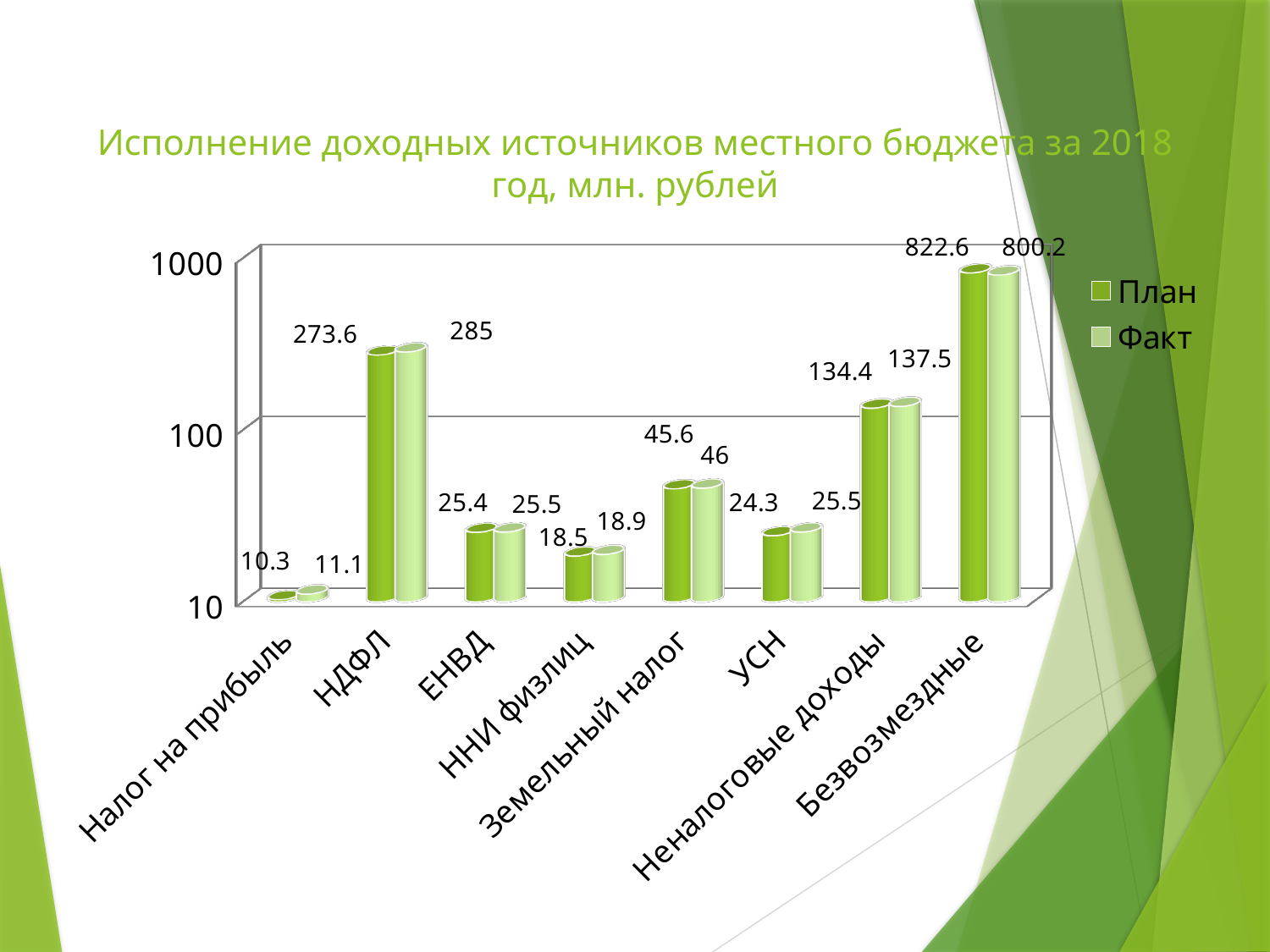
Which is larger for УСН, the План value or the Факт value? Факт What is the difference between the Факт and План values for НДФЛ? 11.4 What is the Факт value for Безвозмездные? 800.2 What kind of chart is shown on the slide? Bar chart Which category has the lowest Факт value? Налог на прибыль What is the План value for Неналоговые доходы? 134.4 How many series does the legend list? 2 How many categories are shown on the x axis? 8 What is the Факт value for Земельный налог? 46 Which category has the highest План value? Безвозмездные What is the План value for НДФЛ? 273.6 What is the difference between the План and Факт values for Безвозмездные? 22.4